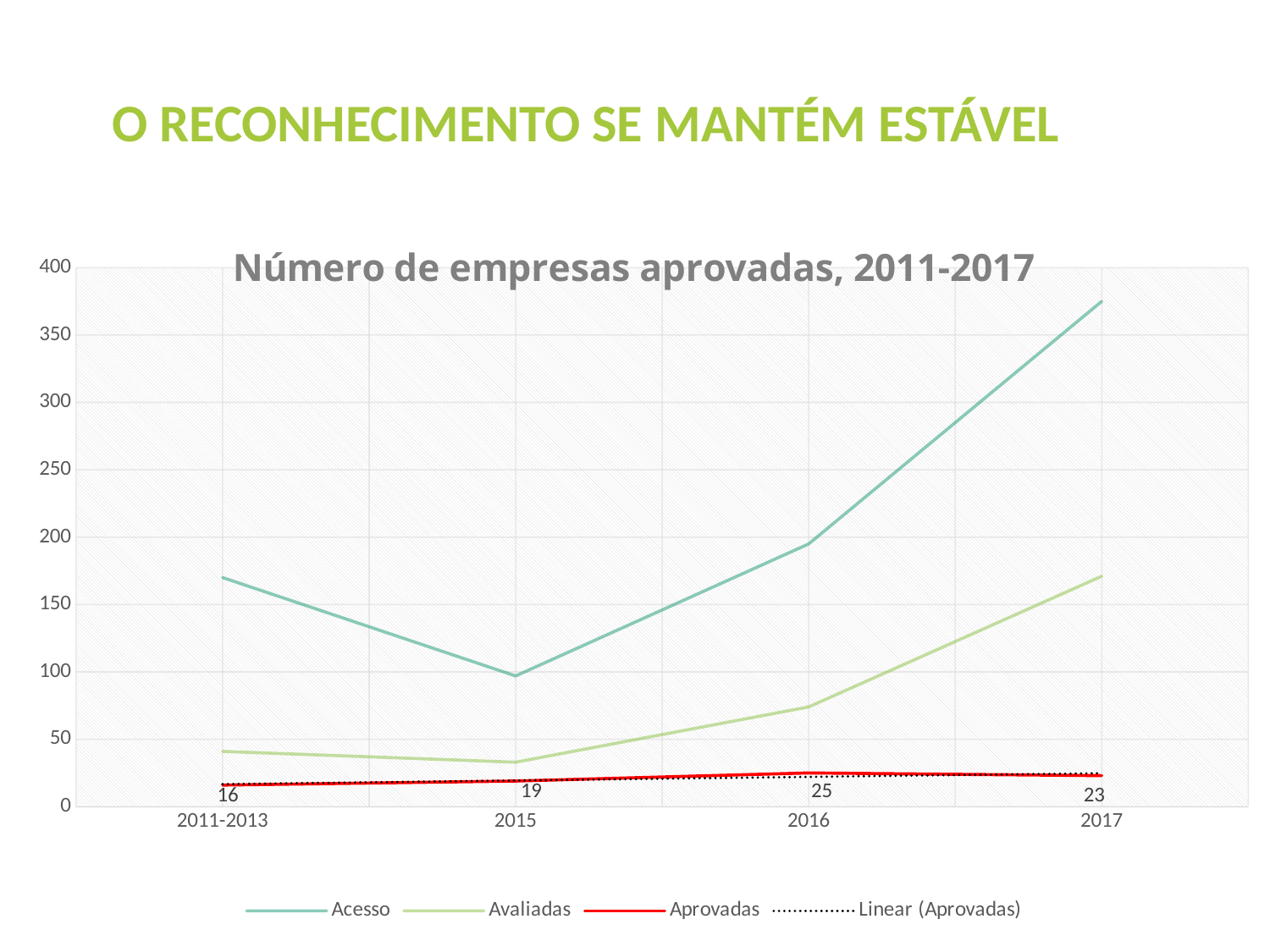
What is the difference between the Aprovadas values for 2016 and 2015? 6 Is the value for Acesso in 2017 greater or less than 350? greater In which period is the Aprovadas value highest? 2016 What is the value for Aprovadas in 2011-2013? 16 Is the value for Avaliadas in 2017 greater or less than 150? greater What kind of chart is shown? line chart Which is larger, the Aprovadas value for 2017 or for 2015? 2017 How many series does the legend list? 4 Does the Acesso series rise or fall from 2015 to 2017? rise In which period is the Aprovadas value lowest? 2011-2013 How many periods are shown on the x axis? 4 What is the value for Aprovadas in 2016? 25